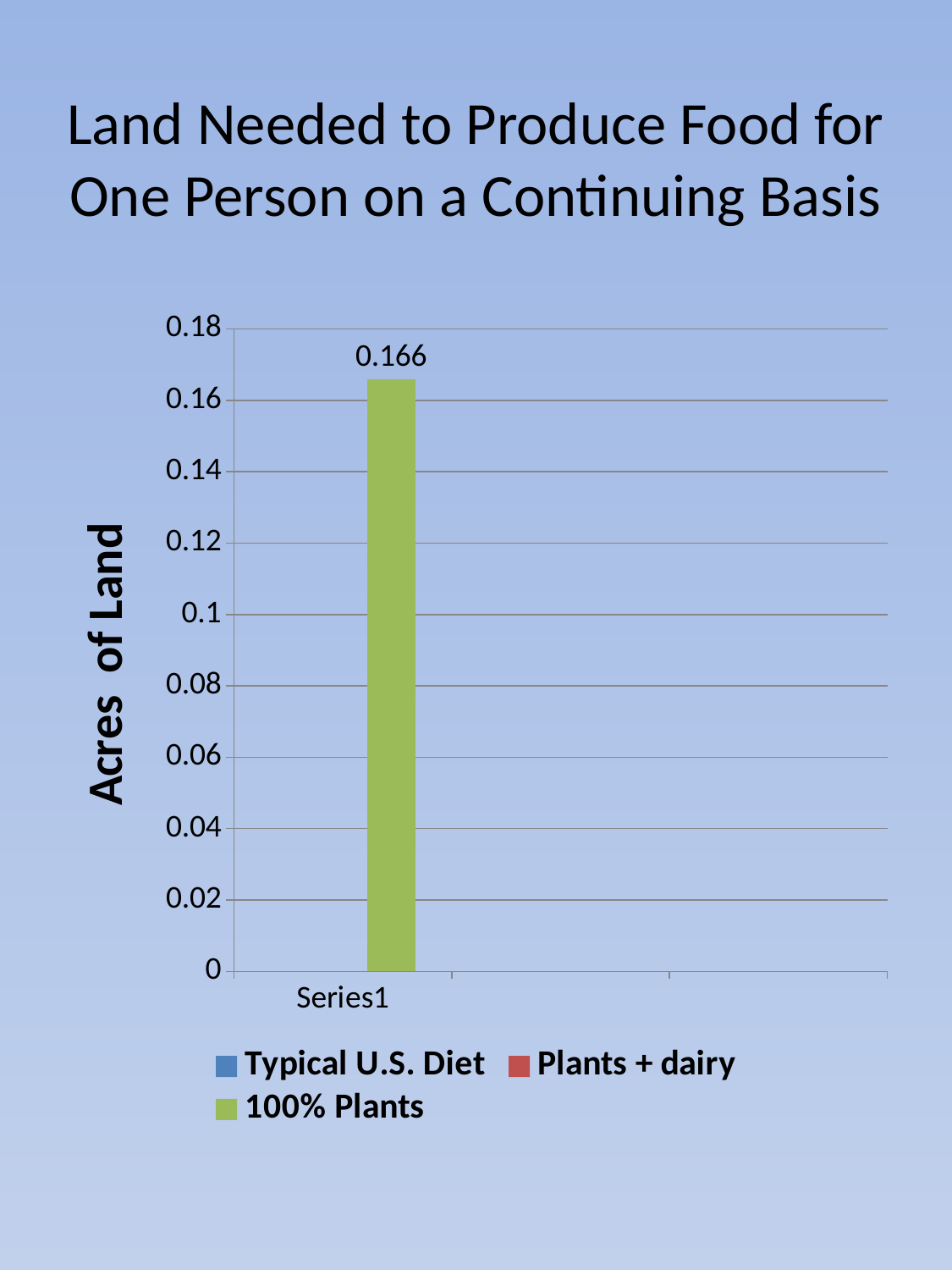
What is the title of the chart? Land Needed to Produce Food for One Person on a Continuing Basis How many series does the legend list? 3 What is the value of the 100% Plants bar? 0.166 Is the value for 100% Plants greater or less than 0.14? greater Is the value for 100% Plants greater or less than 0.18? less How many bars are plotted on the chart? 1 What kind of chart is shown on the slide? bar chart What is the category label shown on the horizontal axis? Series1 What is the label on the vertical axis? Acres of Land